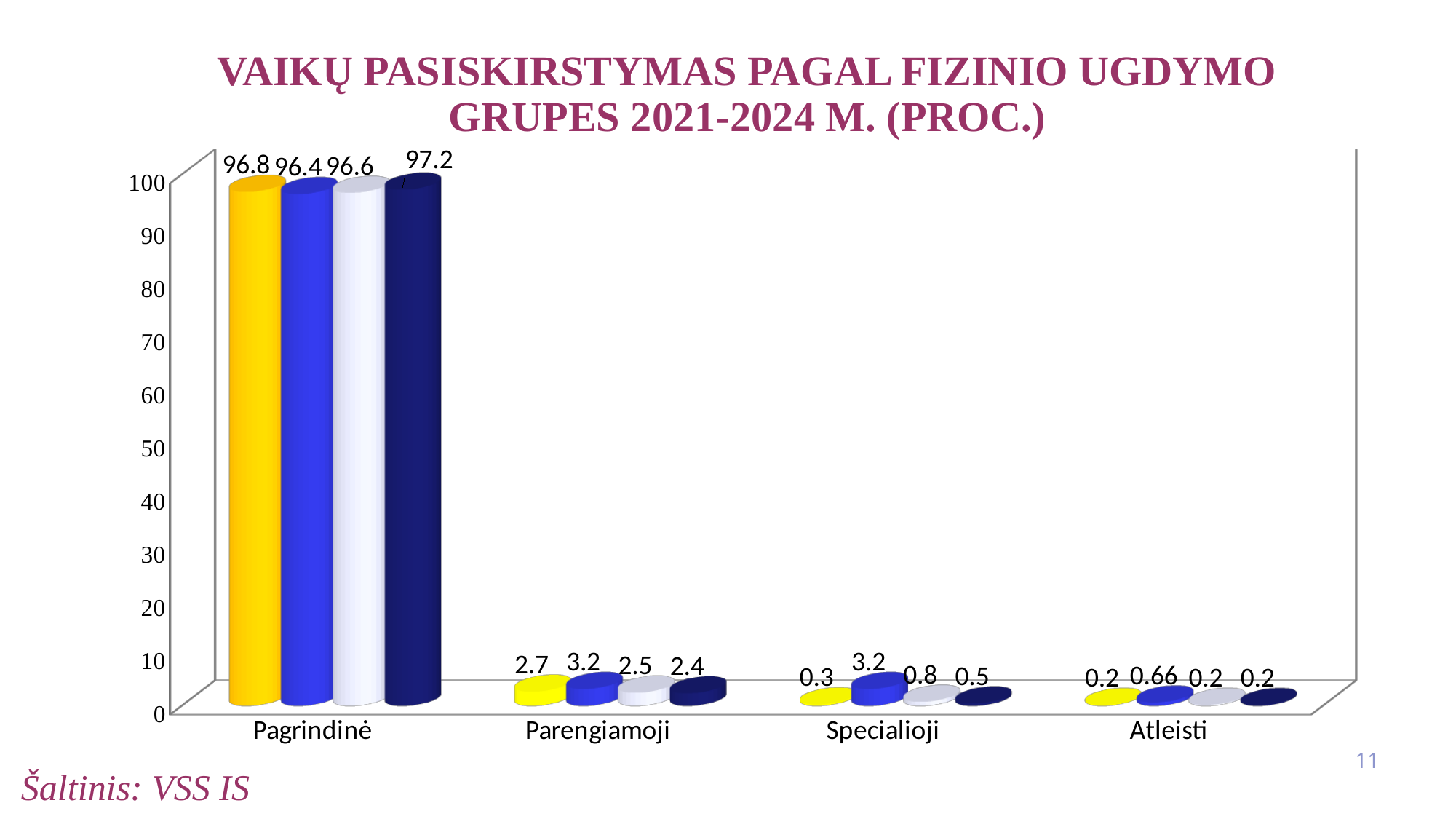
Which category has the highest values in the chart? Pagrindinė For Specialioji, which is larger: the blue (second) bar or the white (third) bar? The blue (second) bar What is the value of the dark navy (fourth) bar for Pagrindinė? 97.2 What is the difference between the dark navy bar (97.2) and the blue bar (96.4) for Pagrindinė? 0.8 What is the value of the blue (second) bar for Atleisti? 0.66 What is the value of the yellow bar for Pagrindinė? 96.8 What source is cited below the chart? VSS IS How many categories are shown on the x axis? 4 What is the value of the blue (second) bar for Parengiamoji? 3.2 Which category has the lowest values in the chart? Atleisti What kind of chart is shown on the slide? Bar chart What is the value of the yellow bar for Specialioji? 0.3